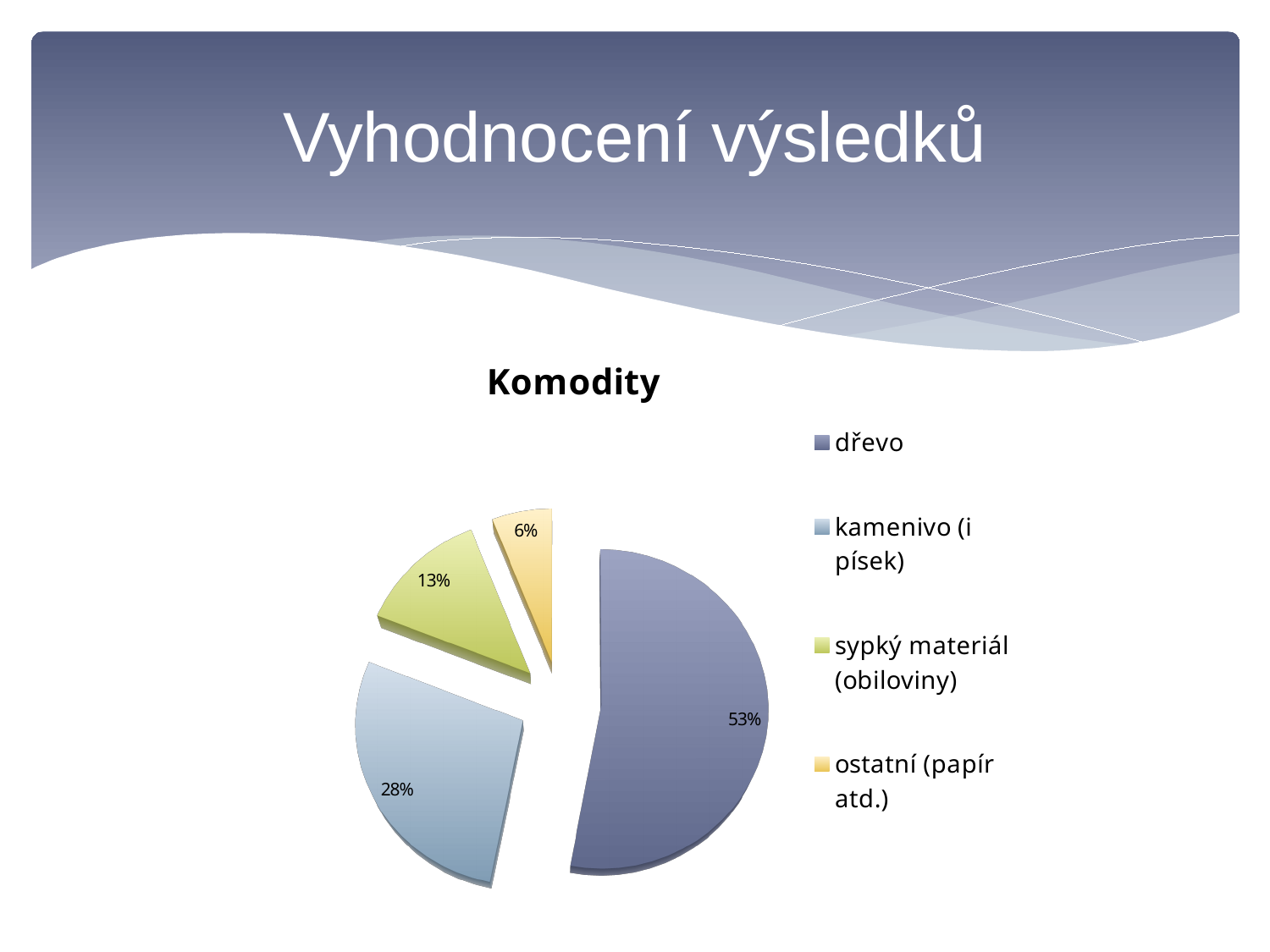
What share of the pie does sypký materiál (obiloviny) have? 13% What colour is the slice for kamenivo (i písek)? light blue What share of the pie does ostatní (papír atd.) have? 6% What is the difference between the shares of dřevo and kamenivo (i písek)? 25% What share of the pie does kamenivo (i písek) have? 28% Which category has the largest share of the pie? dřevo What is the title of the chart? Komodity How many categories does the pie chart show? 4 What share of the pie does dřevo have? 53% Which is larger, the share of sypký materiál (obiloviny) or the share of ostatní (papír atd.)? sypký materiál (obiloviny) Which category has the smallest share of the pie? ostatní (papír atd.) What kind of chart is shown on the slide? pie chart